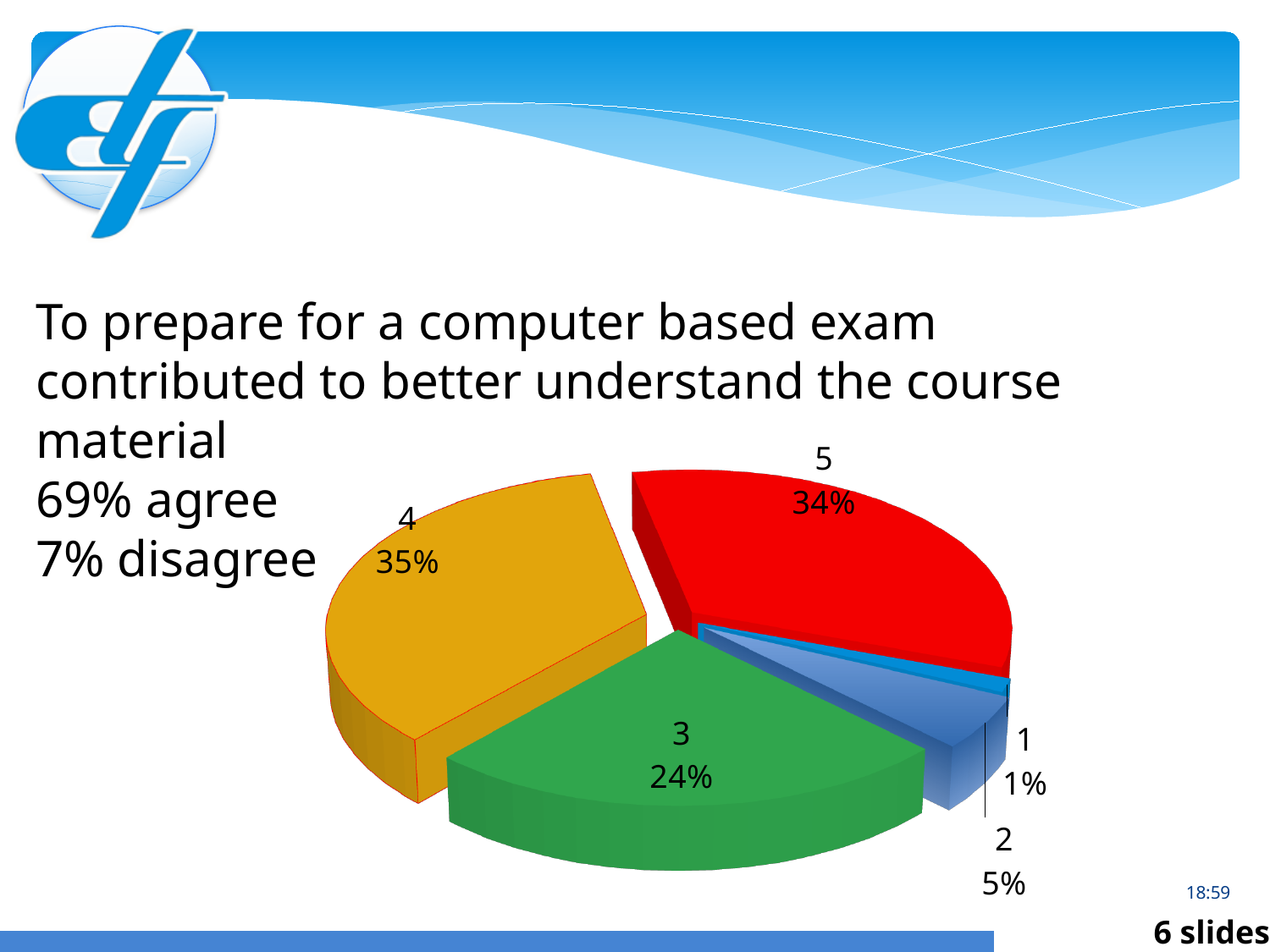
How many slices does the pie chart have? 5 What percentage is shown for category 3 in the pie chart? 24% What colour is the slice for category 3 in the pie chart? green Which has a larger share in the pie chart, category 3 or category 2? 3 What is the combined share of categories 4 and 5 in the pie chart? 69% What kind of chart is shown on the slide? pie chart What percentage is shown for category 1 in the pie chart? 1% Which category has the smallest slice in the pie chart? 1 What percentage is shown for category 5 in the pie chart? 34% Which category has the largest slice in the pie chart? 4 What percentage is shown for category 2 in the pie chart? 5% What is the difference in percentage points between category 4 and category 3 in the pie chart? 11